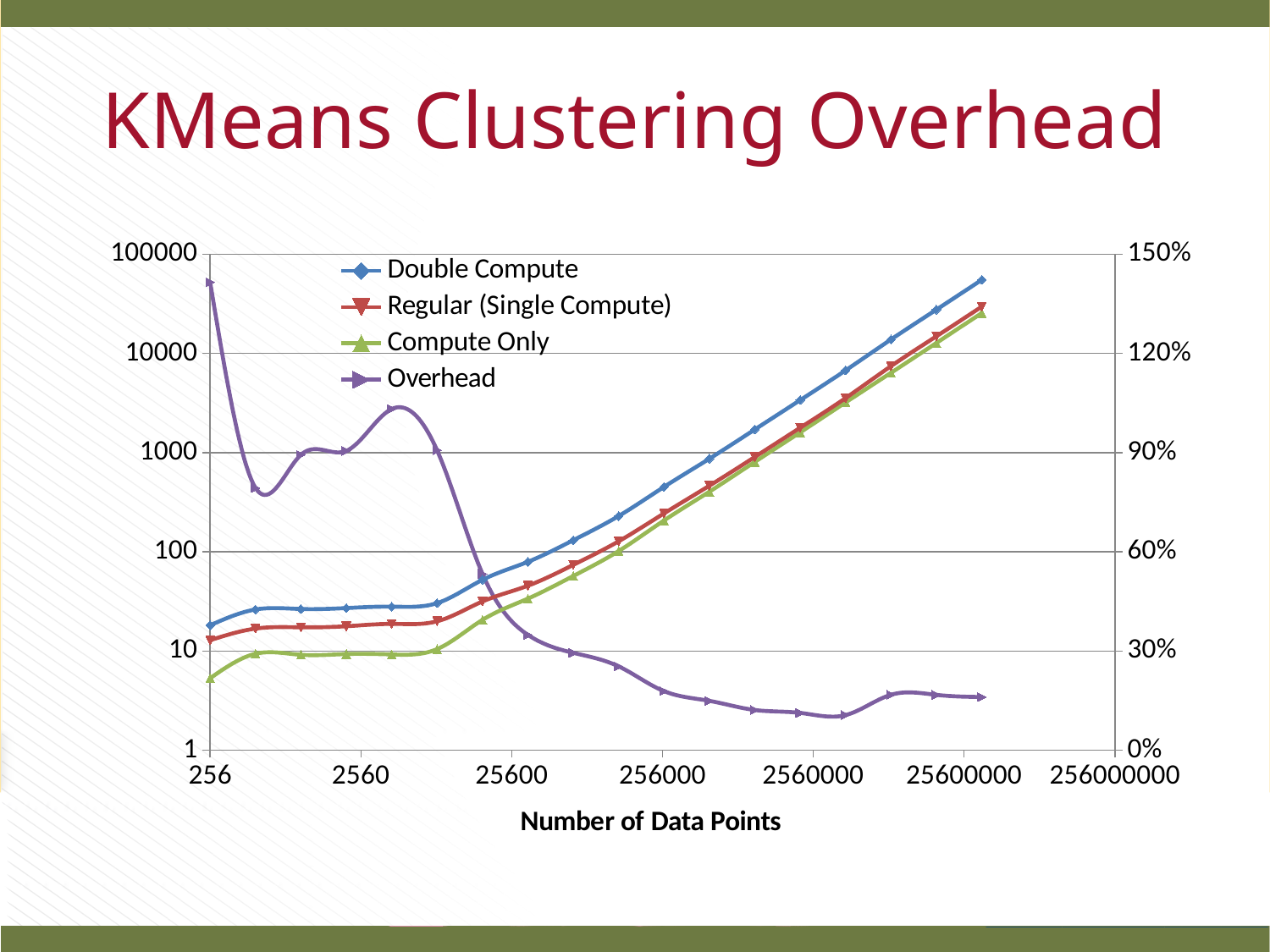
At 256 data points, which is larger: Double Compute or Compute Only? Double Compute What is the title of the chart? KMeans Clustering Overhead Is the Double Compute value at its rightmost data point greater or less than 10000? greater Is the Compute Only value at 256 data points greater or less than 10? less Does the Double Compute series rise or fall as the number of data points increases? rise Among Double Compute, Regular (Single Compute) and Compute Only, which series is highest at the rightmost data point? Double Compute Does the Overhead series generally rise or fall as the number of data points increases? fall What is the label of the x axis? Number of Data Points How many series does the legend list? 4 Is the Overhead value at the rightmost data point greater or less than 30%? less What kind of chart is shown on the slide? line chart